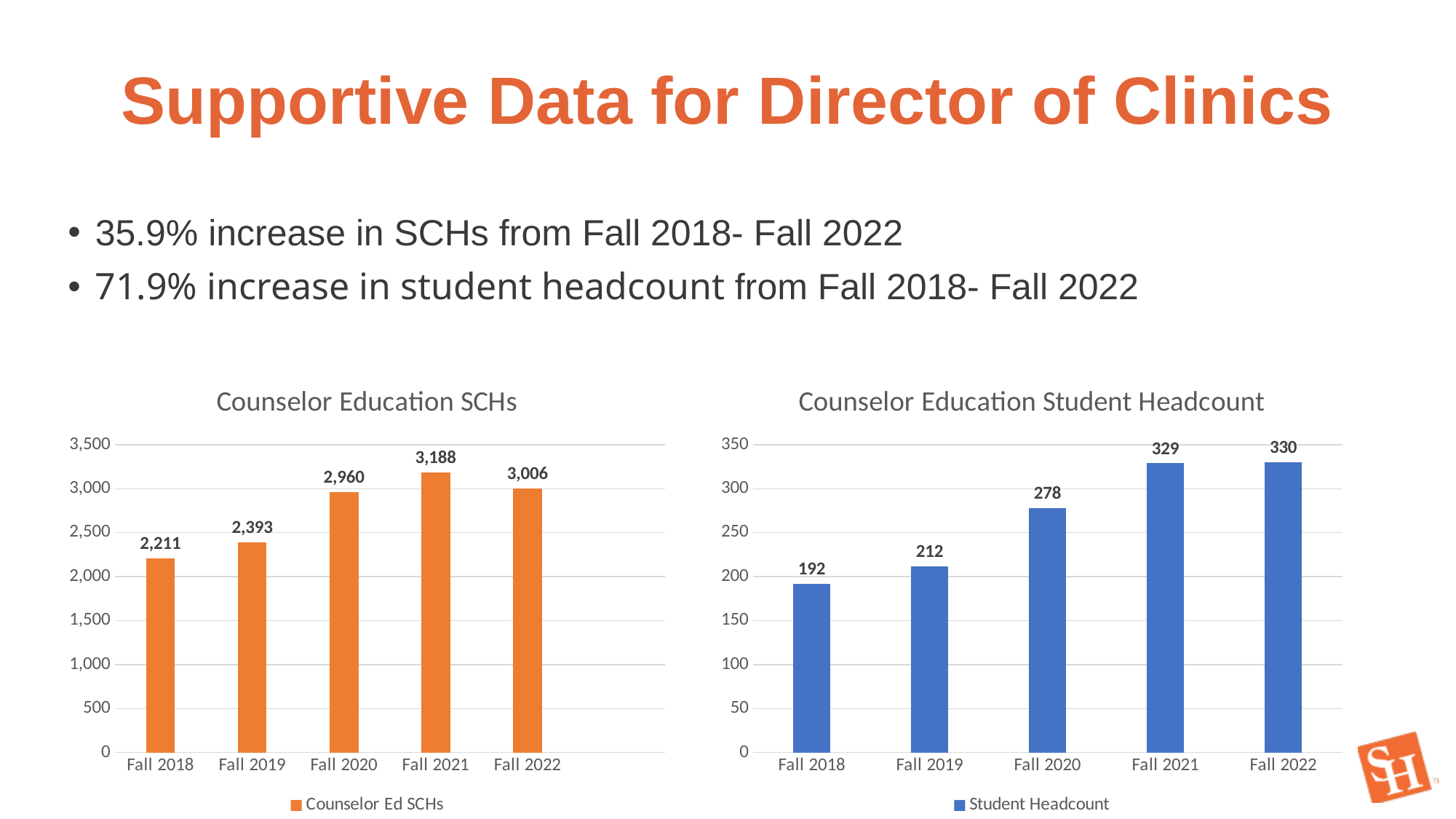
What kind of chart is the Counselor Education SCHs chart? bar chart How many terms are shown on the x axis of the Counselor Education SCHs chart? 5 In the Counselor Education Student Headcount chart, what is the difference between the Fall 2022 and Fall 2018 values? 138 In the Counselor Education Student Headcount chart, is the value for Fall 2020 greater or less than 250? greater How many series does the legend of the Counselor Education Student Headcount chart list? 1 In the Counselor Education Student Headcount chart, which term has the lowest value? Fall 2018 In the Counselor Education Student Headcount chart, what is the value for Fall 2019? 212 In the Counselor Education SCHs chart, which term has the highest value? Fall 2021 In the Counselor Education SCHs chart, what is the value for Fall 2020? 2,960 In the Counselor Education Student Headcount chart, do the values rise or fall from Fall 2018 to Fall 2022? rise In the Counselor Education SCHs chart, what is the difference between the Fall 2021 and Fall 2022 values? 182 In the Counselor Education SCHs chart, which is larger, the value for Fall 2019 or the value for Fall 2020? Fall 2020